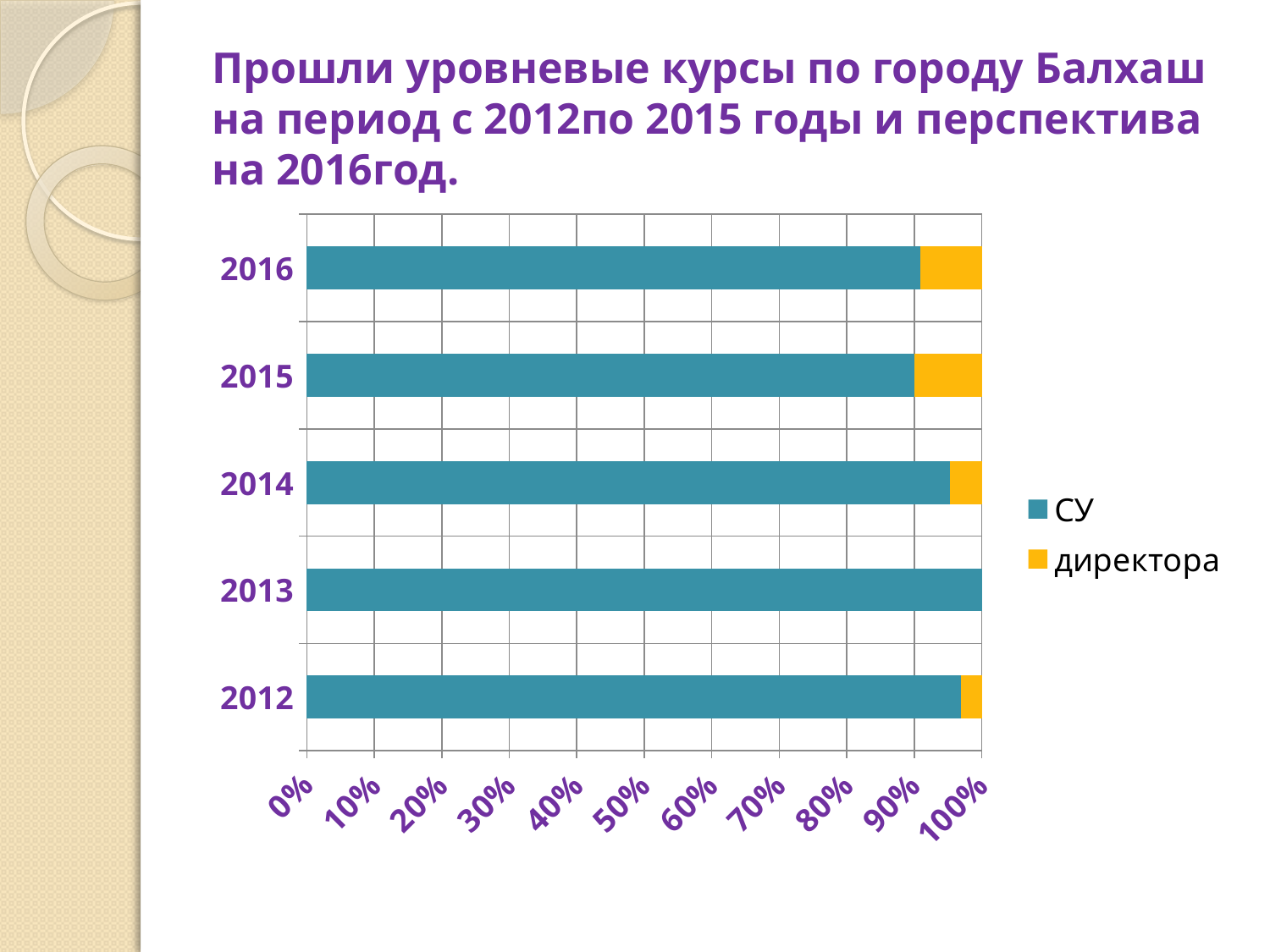
Which is larger, the директора share in 2012 or in 2015? 2015 What are the two series named in the legend? СУ and директора What kind of chart is shown on the slide? bar chart Which year has the highest share for СУ? 2013 Is the value for директора in 2015 greater or less than 20%? less Is the value for СУ in 2016 greater or less than 80%? greater Is the value for СУ in 2012 greater or less than 90%? greater How many series does the legend list? 2 How many years (categories) are shown on the chart? 5 Which is larger, the СУ share in 2014 or in 2015? 2014 Which colour represents the series директора? yellow What is the value for СУ in 2013? 100%